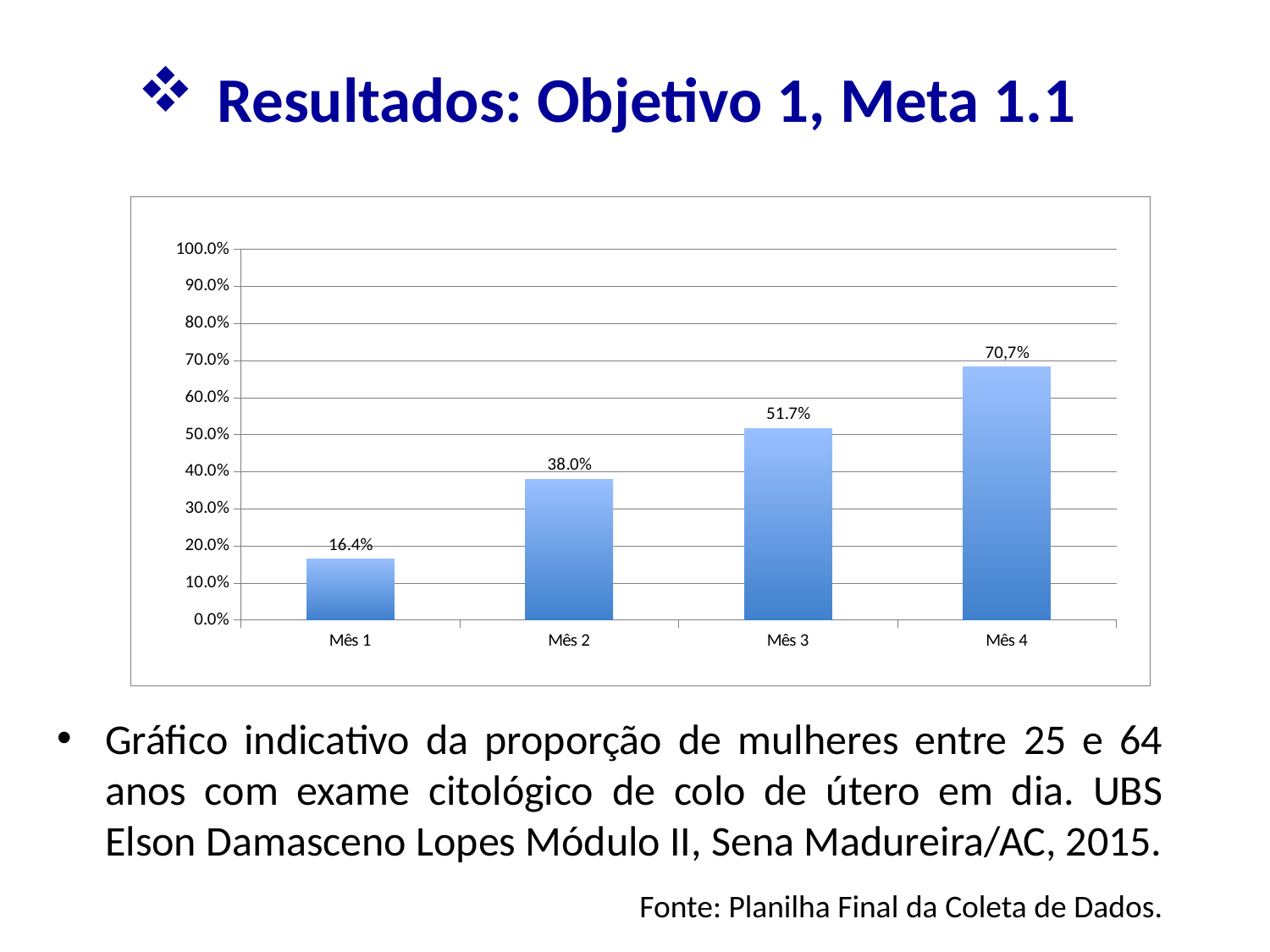
Which month has the lowest value? Mês 1 What kind of chart is shown on the slide? bar chart How many months are shown on the x axis? 4 Which is larger, the value for Mês 3 or the value for Mês 2? Mês 3 Do the values rise or fall from Mês 1 to Mês 4? rise What is the value for Mês 1? 16.4% What is the value for Mês 3? 51.7% Is the value for Mês 3 greater or less than 50.0%? greater What is the difference between the values for Mês 2 and Mês 1? 21.6% Which month has the highest value? Mês 4 What is the value for Mês 4? 70,7% What is the value for Mês 2? 38.0%